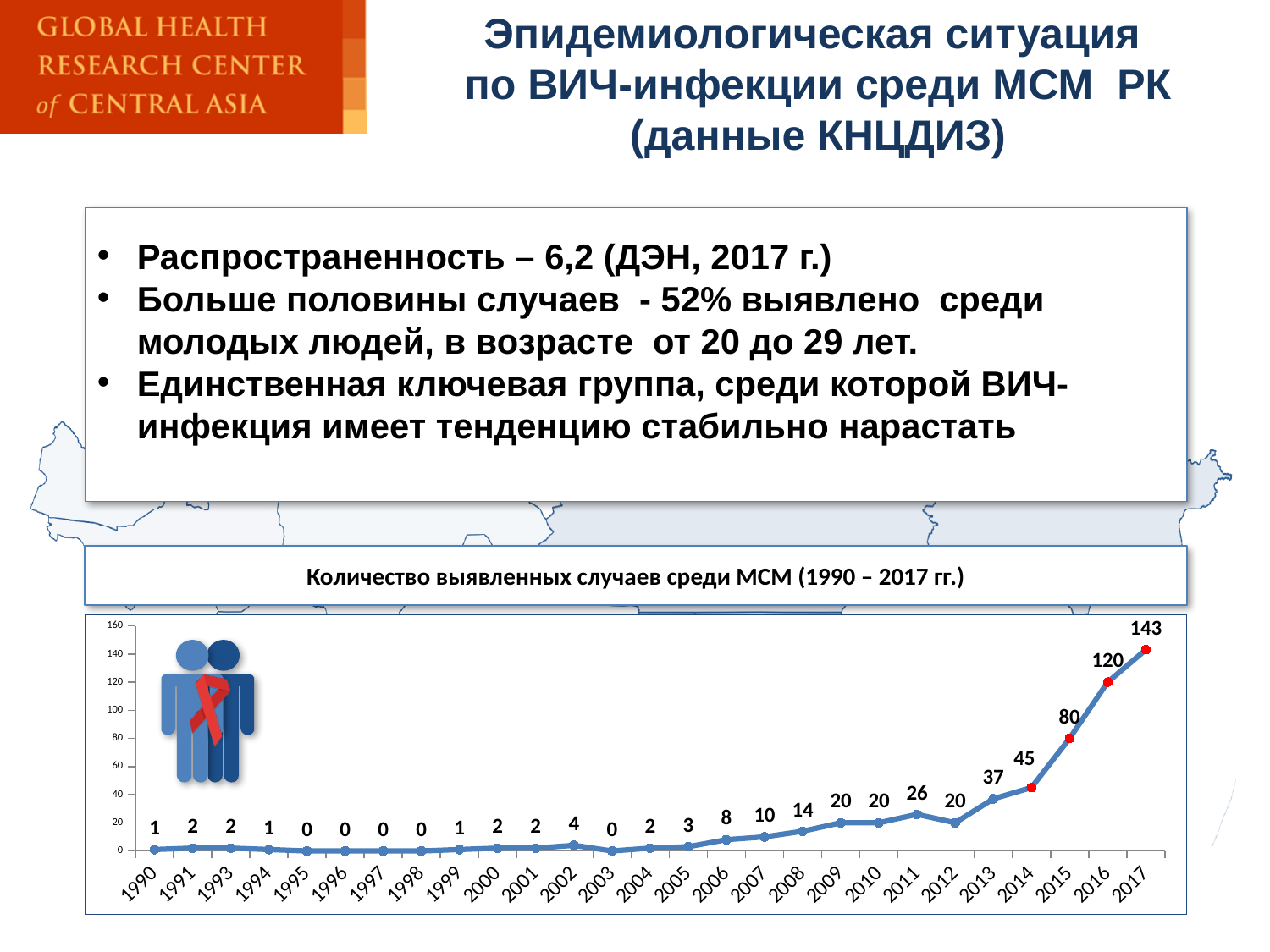
What is the value for 2011 in the chart? 26 Is the value for 2016 greater or less than 100? greater What kind of chart is shown on the slide? line chart What is the title of the chart? Количество выявленных случаев среди МСМ (1990 – 2017 гг.) What is the difference between the values for 2015 and 2014? 35 What is the value for 2017 in the chart? 143 Do the values generally rise or fall from 2012 to 2017? rise Which year has the highest value in the chart? 2017 Which year has the larger value, 2011 or 2012? 2011 What is the difference between the values for 2017 and 2016? 23 What is the value for 2013 in the chart? 37 What is the value for 2015 in the chart? 80